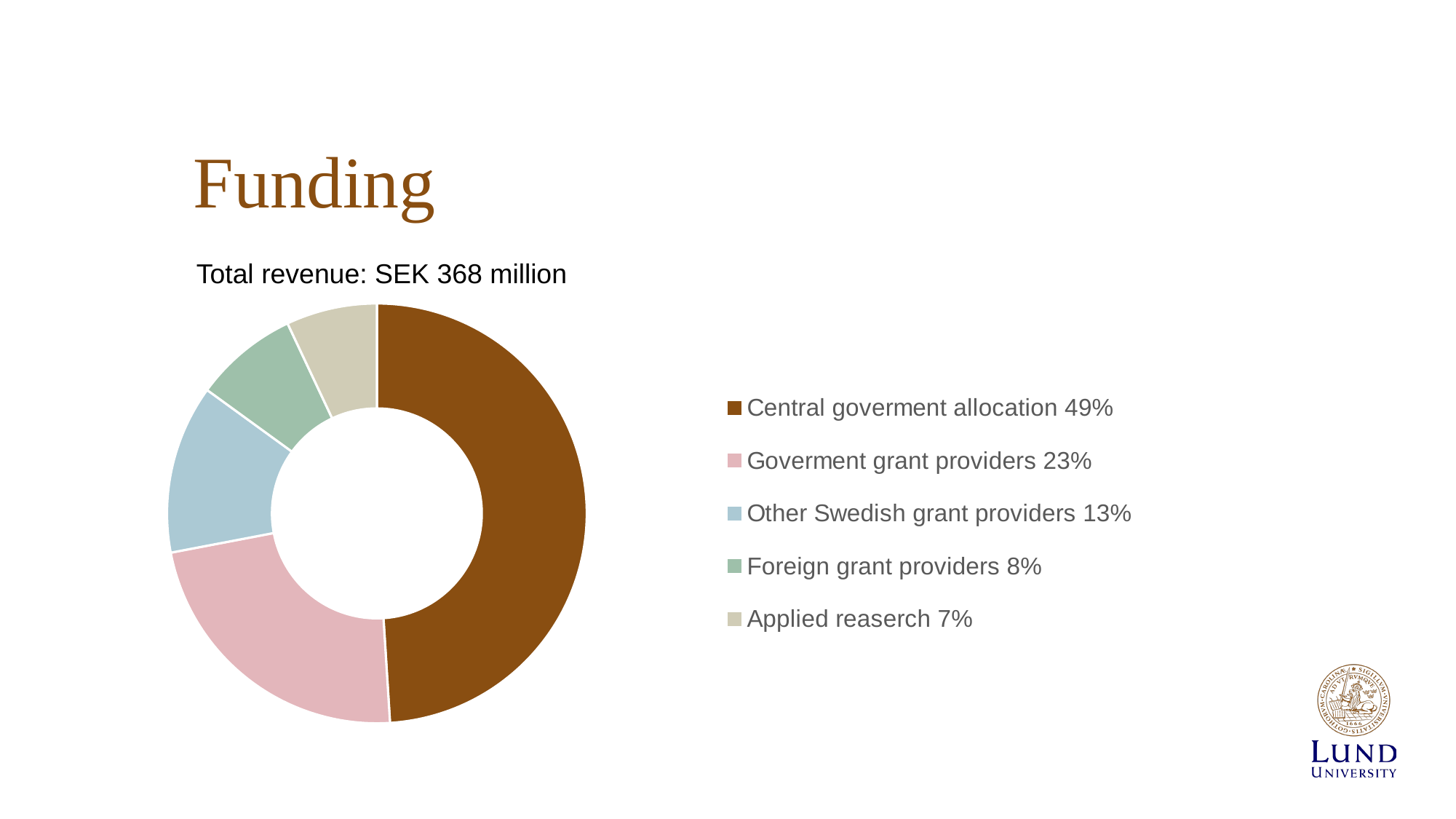
What share of funding comes from Applied reaserch? 7% What share of funding comes from Foreign grant providers? 8% What total revenue is stated above the chart? SEK 368 million How many funding categories are shown in the chart? 5 What share of funding comes from Central goverment allocation? 49% Which is larger, the share for Other Swedish grant providers or Foreign grant providers? Other Swedish grant providers What is the difference in percentage points between Central goverment allocation and Goverment grant providers? 26 Which funding source has the largest share? Central goverment allocation What kind of chart is shown on the slide? Doughnut (pie) chart Which funding source has the smallest share? Applied reaserch